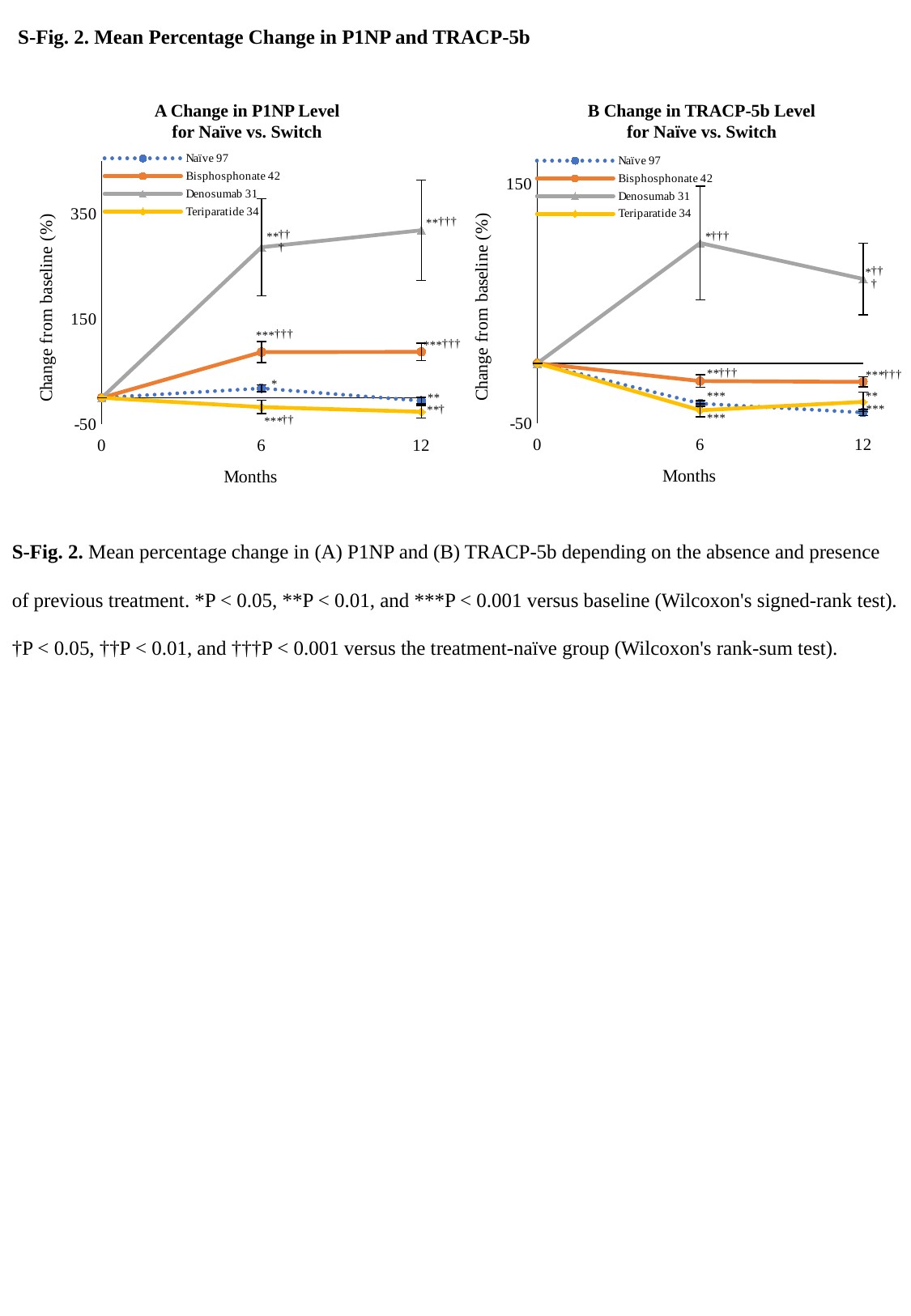
What is the x-axis label of the right chart 'B Change in TRACP-5b Level'? Months In the left chart 'A Change in P1NP Level', which is larger at 12 months: Denosumab 31 or Bisphosphonate 42? Denosumab 31 In the left chart 'A Change in P1NP Level', is the value for Bisphosphonate 42 at 12 months greater or less than 150? less In the left chart 'A Change in P1NP Level', does the Denosumab 31 series rise or fall from 0 to 12 months? rise How many time points are plotted along the x axis of the right chart 'B Change in TRACP-5b Level'? 3 In the right chart 'B Change in TRACP-5b Level', which is larger at 6 months: Denosumab 31 or Teriparatide 34? Denosumab 31 In the left chart 'A Change in P1NP Level', is the value for Denosumab 31 at 6 months greater or less than 150? greater What type of chart is the left chart, 'A Change in P1NP Level for Naïve vs. Switch'? line chart How many series does the legend of the left chart 'A Change in P1NP Level' list? 4 In the right chart 'B Change in TRACP-5b Level', is the value for Denosumab 31 at 6 months greater or less than 150? less In the left chart 'A Change in P1NP Level', which series has the highest value at 12 months? Denosumab 31 In the right chart 'B Change in TRACP-5b Level', which series has the highest value at 6 months? Denosumab 31